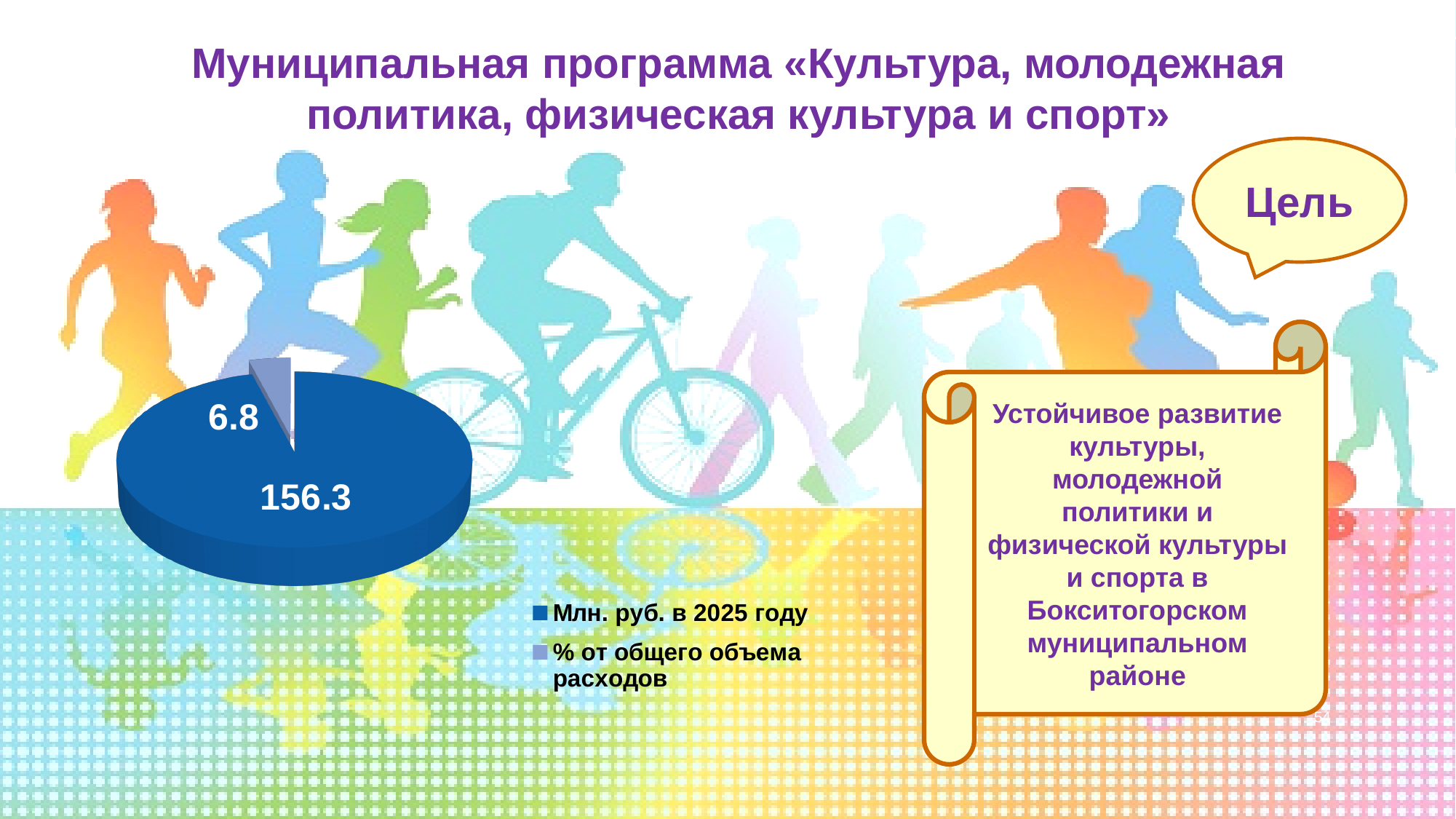
How many slices does the pie chart have? 2 What type of chart is shown on the slide? pie chart What colour is the slice labelled 156.3? blue Is the value for "Млн. руб. в 2025 году" larger or smaller than the value for "% от общего объема расходов"? larger Which legend entry has the smaller value on the pie chart? % от общего объема расходов What is the title of the slide containing the pie chart? Муниципальная программа «Культура, молодежная политика, физическая культура и спорт» What value is shown for "Млн. руб. в 2025 году" on the pie chart? 156.3 Which legend entry has the larger value on the pie chart? Млн. руб. в 2025 году How many entries does the chart legend list? 2 What value is shown for "% от общего объема расходов" on the pie chart? 6.8